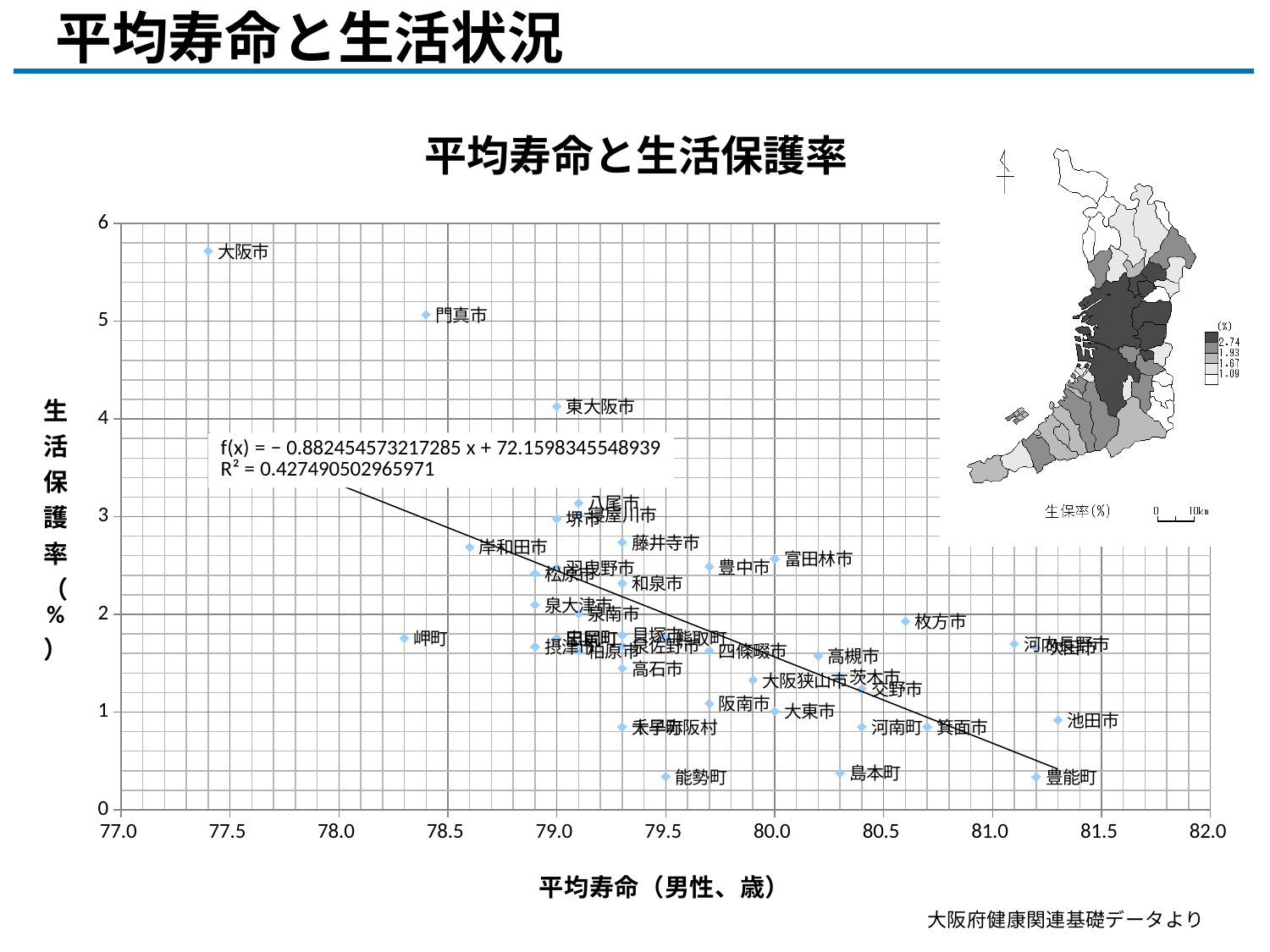
Which has a higher 生活保護率, 東大阪市 or 枚方市? 東大阪市 Which has a higher 生活保護率, 大阪市 or 門真市? 大阪市 Is the 生活保護率 for 岸和田市 greater or less than 2? greater What kind of chart is shown on the slide? Scatter plot What R² value is shown on the chart? 0.427490502965971 According to the trend line, does 生活保護率 rise or fall as 平均寿命 increases? fall Is the 平均寿命 for 大阪市 greater or less than 78.0? less Is the 生活保護率 for 豊能町 greater or less than 1? less What is the title of the chart? 平均寿命と生活保護率 Which municipality has the lowest 平均寿命 (x-axis value) in the chart? 大阪市 Which municipality has the highest 生活保護率 in the chart? 大阪市